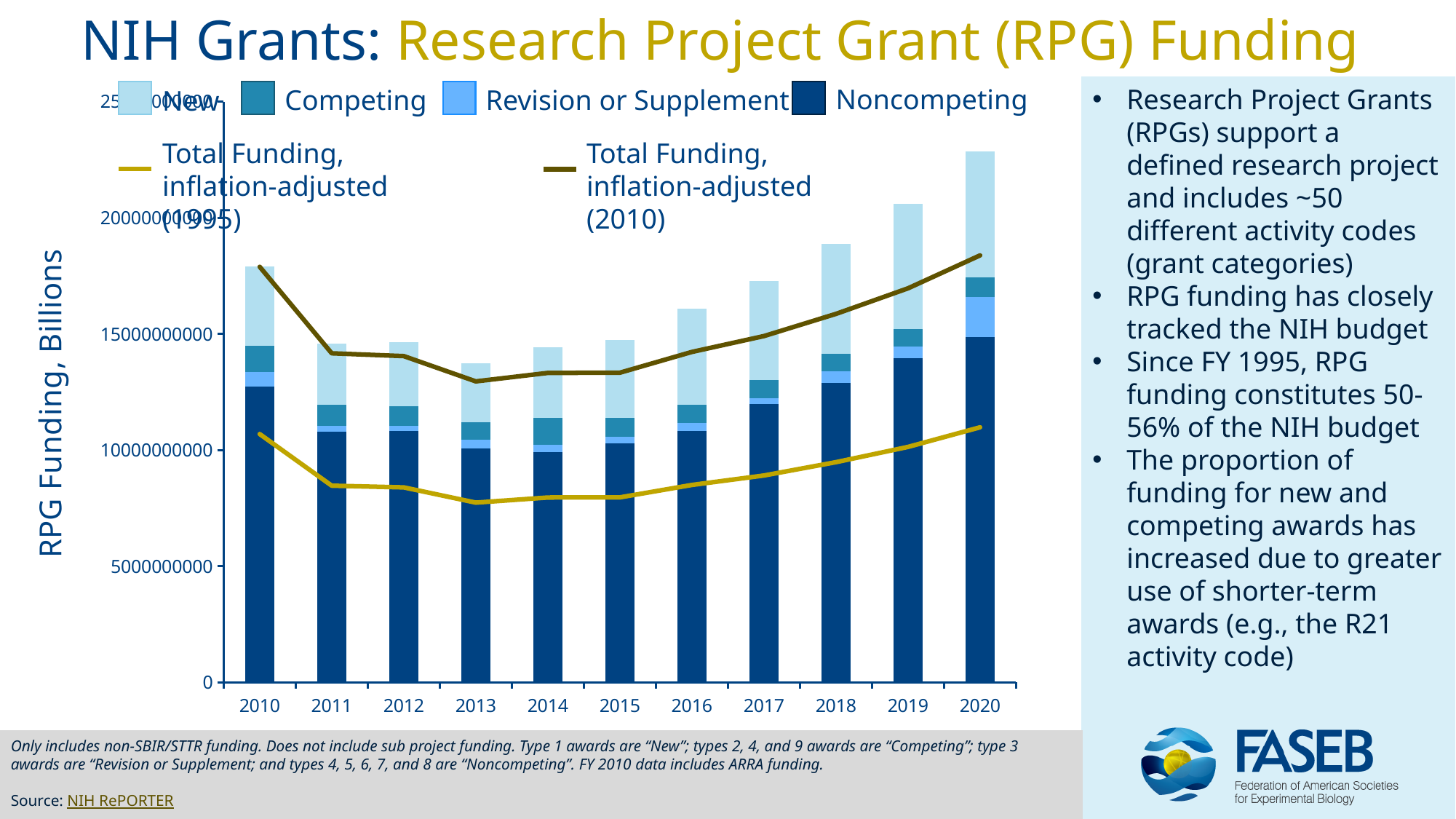
How many years are shown on the x axis of the chart? 11 What is the label on the chart's y axis? RPG Funding, Billions What kind of chart is shown on the slide? Stacked bar chart with line series Which year has the lowest total RPG funding bar? 2013 Is the total RPG funding bar for 2020 greater or less than 20000000000? greater Is the total RPG funding bar for 2016 greater or less than 15000000000? greater Do the total RPG funding bars rise or fall from 2013 to 2020? rise Is the Noncompeting value for 2010 greater or less than 10000000000? greater Which year has the highest total RPG funding bar? 2020 How many series does the chart's legend list? 6 Which year has the larger total RPG funding bar, 2010 or 2020? 2020